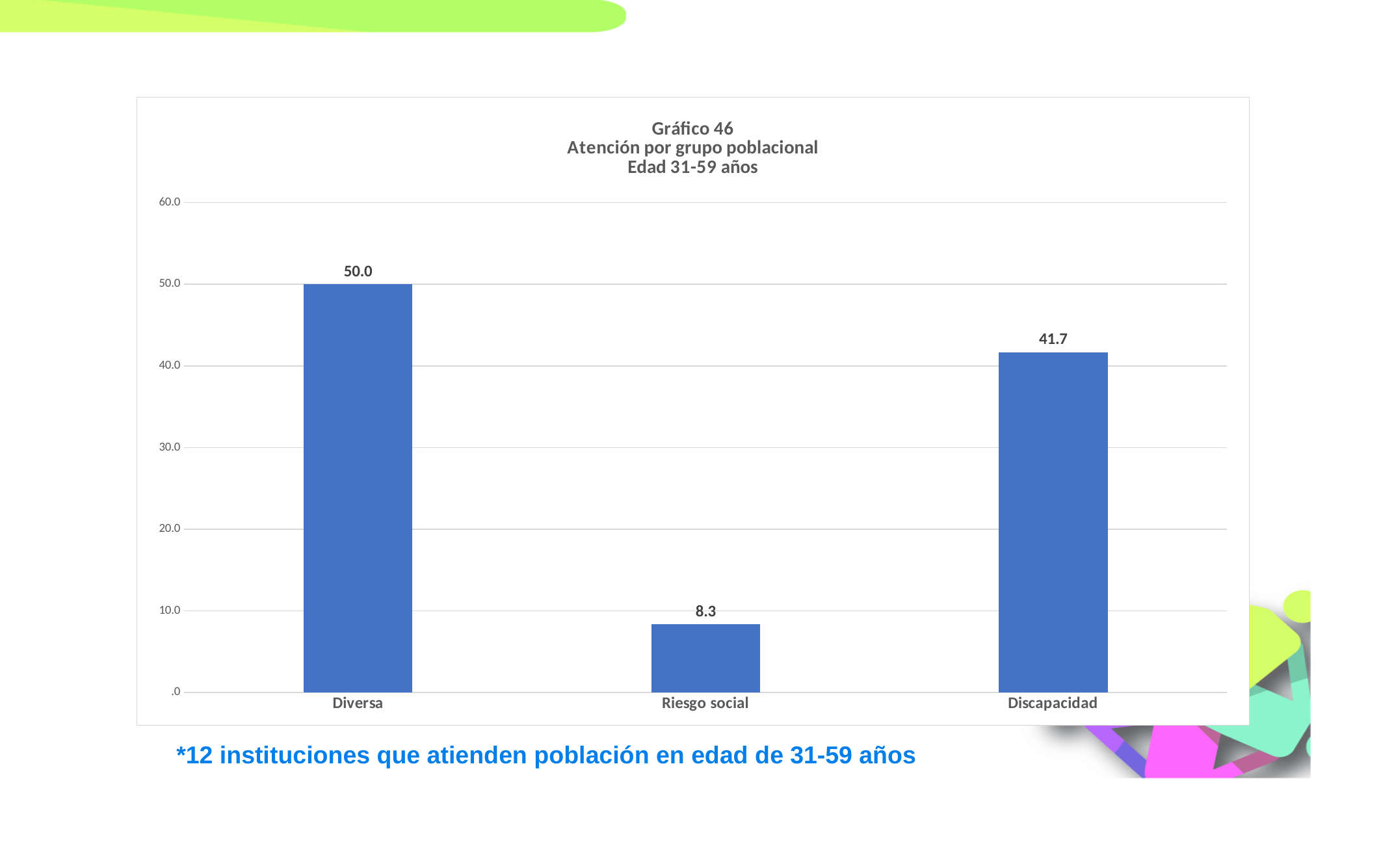
What is the value for Riesgo social? 8.3 What age range is given in the chart title? 31-59 años How many categories are shown on the x axis? 3 Which category has the highest value? Diversa Which is larger, the value for Discapacidad or the value for Riesgo social? Discapacidad What is the value for Discapacidad? 41.7 What kind of chart is shown on the slide? Bar chart What is the value for Diversa? 50.0 Which category has the lowest value? Riesgo social Is the value for Discapacidad greater or less than 40.0? greater What is the difference between the values for Discapacidad and Riesgo social? 33.4 What is the difference between the values for Diversa and Discapacidad? 8.3